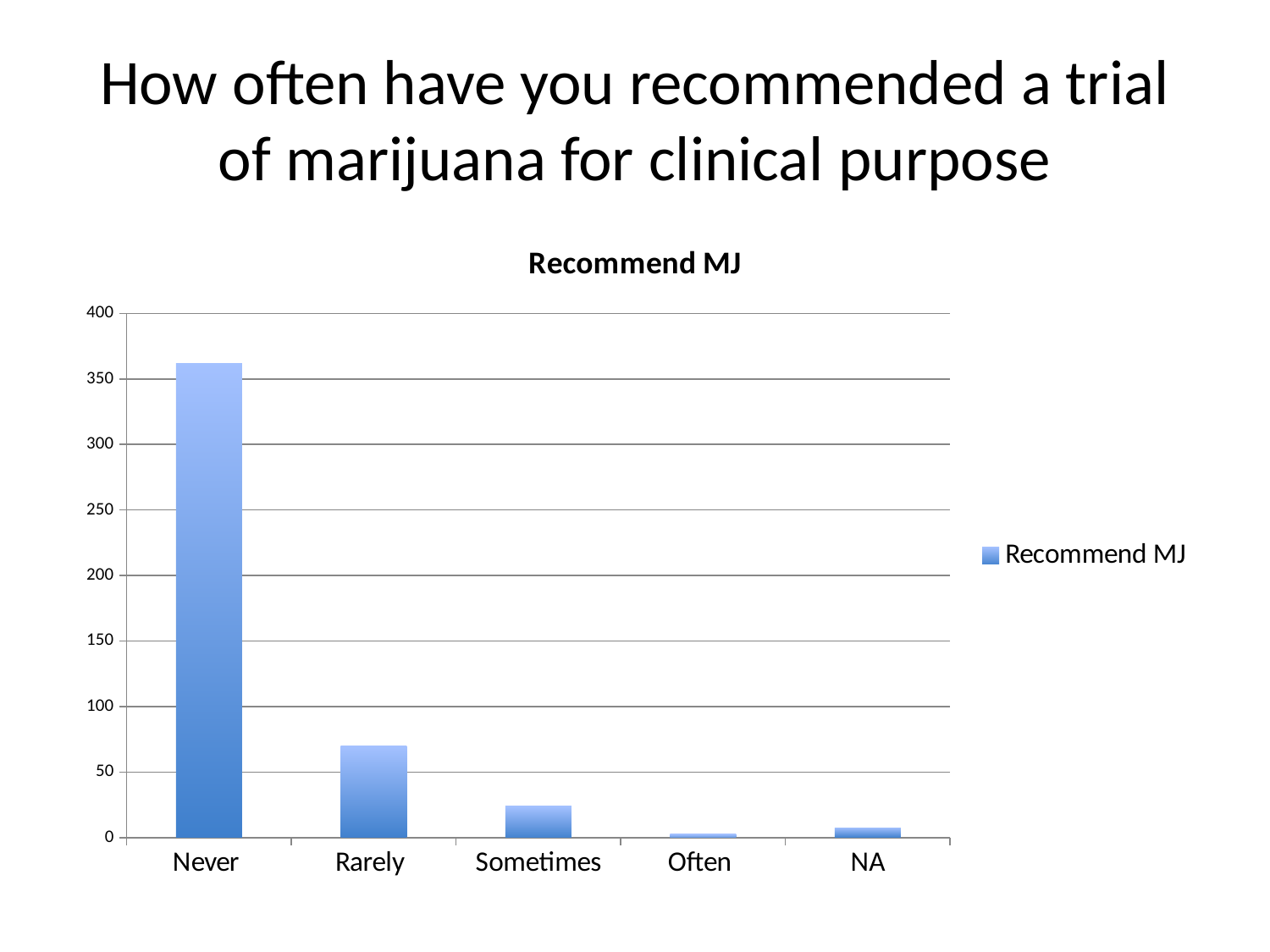
Is the value for Rarely greater or less than 50? greater Which is larger, the value for NA or the value for Often? NA What is the title of the chart? Recommend MJ Is the value for Never greater or less than 350? greater Which is larger, the value for Rarely or the value for Sometimes? Rarely How many categories are shown on the x axis of the chart? 5 What kind of chart is shown on the slide? bar chart Which category has the highest value? Never Which category has the lowest value? Often How many series does the legend list? 1 Is the value for Rarely greater or less than 100? less